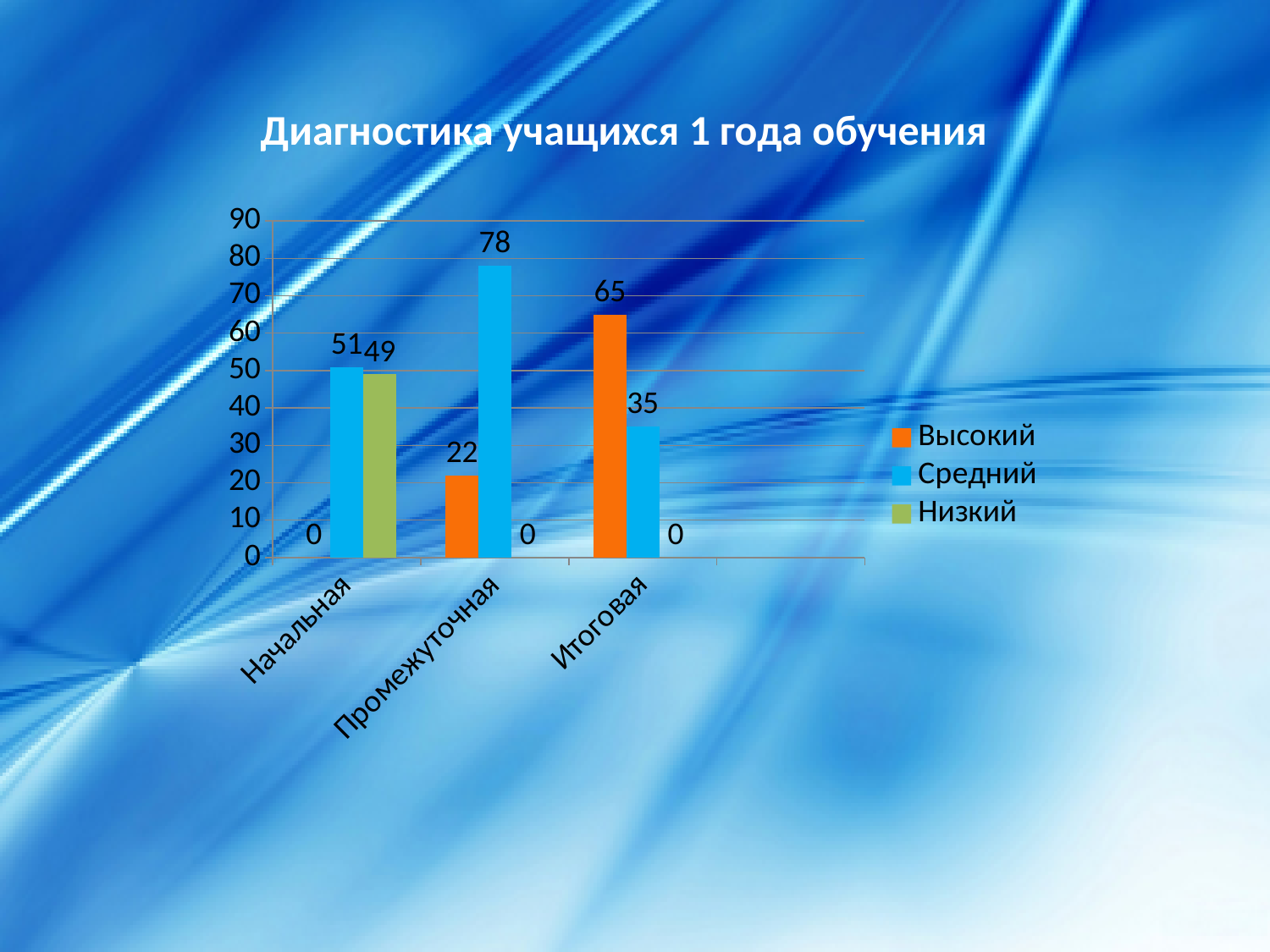
What is the value of Средний for Начальная? 51 What is the title of the chart? Диагностика учащихся 1 года обучения Which category has the highest value for Средний? Промежуточная Which is larger for Итоговая: Высокий or Средний? Высокий What is the difference between the Средний values for Промежуточная and Итоговая? 43 What kind of chart is shown on the slide? Bar chart What is the value of Высокий for Промежуточная? 22 How many categories are shown on the x axis? 3 What is the value of Низкий for Начальная? 49 How many series does the legend list? 3 Which category has the lowest value for Высокий? Начальная What is the value of Высокий for Итоговая? 65